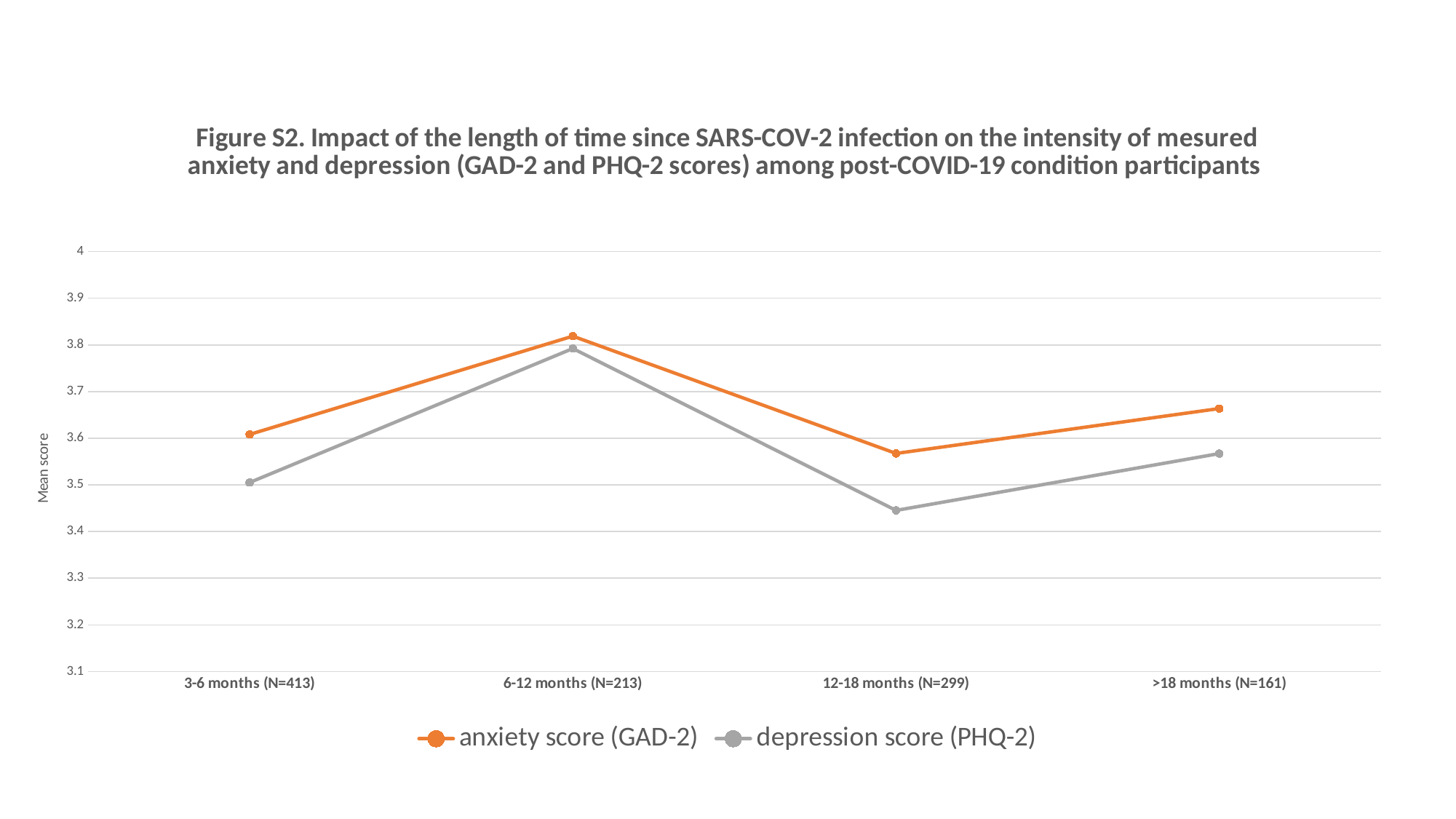
What is the label on the y axis? Mean score Is the depression score (PHQ-2) at 12-18 months (N=299) greater or less than 3.5? less At which time category is the depression score (PHQ-2) lowest? 12-18 months (N=299) What kind of chart is shown on the slide? line chart How many series does the legend list? 2 Is the depression score (PHQ-2) at >18 months (N=161) greater or less than 3.6? less At which time category is the anxiety score (GAD-2) highest? 6-12 months (N=213) Is the anxiety score (GAD-2) at >18 months (N=161) greater or less than 3.6? greater How many time-since-infection categories are plotted on the x axis? 4 Does the depression score (PHQ-2) rise or fall from 6-12 months to 12-18 months? fall At which time category is the anxiety score (GAD-2) lowest? 12-18 months (N=299) At 3-6 months (N=413), which is larger: the anxiety score (GAD-2) or the depression score (PHQ-2)? anxiety score (GAD-2)